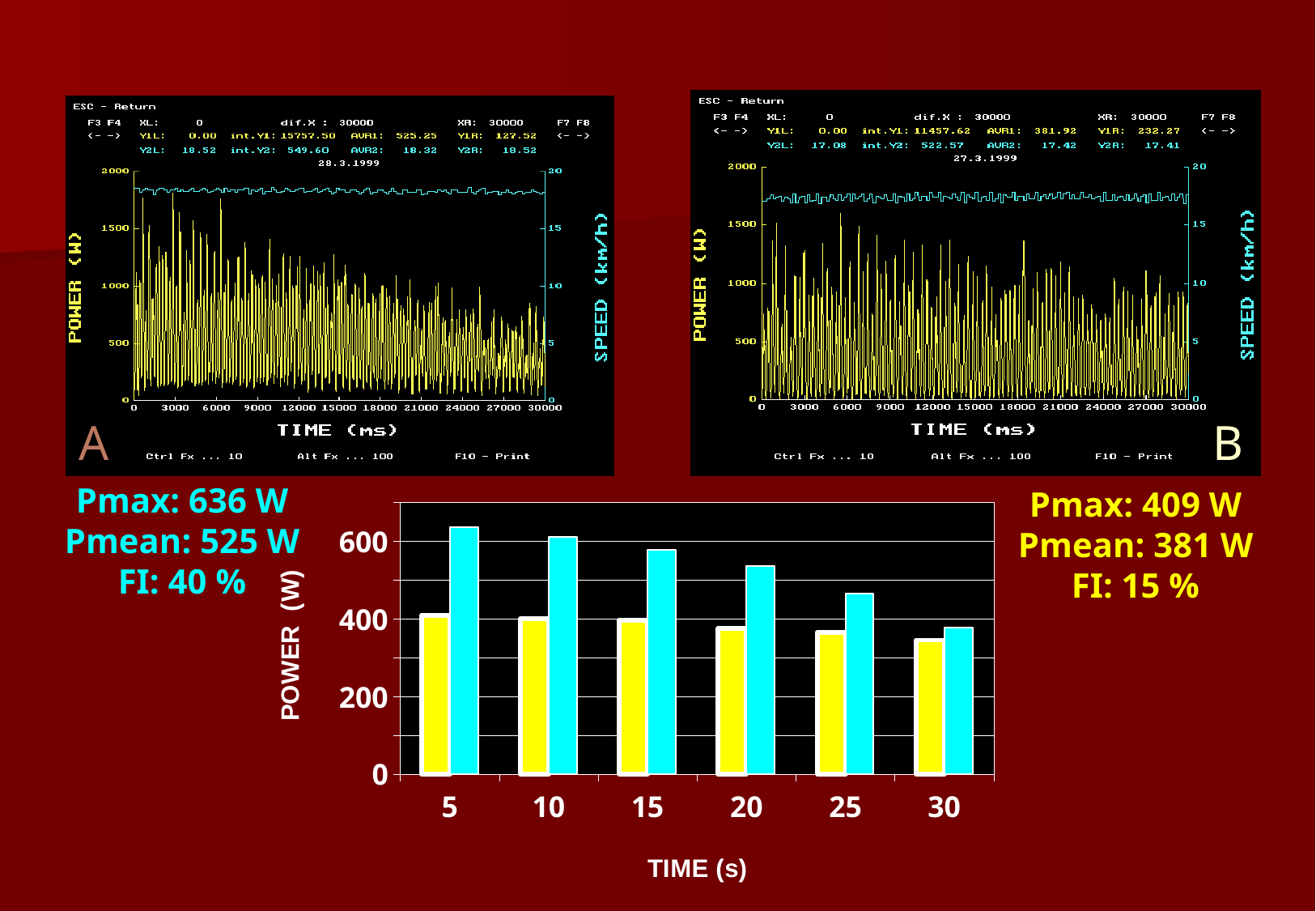
In the bottom bar chart, at which time is the cyan bar lowest? 30 In the bottom bar chart, how many time categories are shown on the x axis? 6 In the bottom bar chart, is the cyan bar at 5 s greater or less than 600? greater In the bottom bar chart, which bar is taller at 5 s, the yellow bar or the cyan bar? the cyan bar What kind of chart is the chart at the bottom of the slide with TIME (s) on the x axis? bar chart In the bottom bar chart, is the yellow bar at 30 s greater or less than 400? less What is the y-axis title of the bottom bar chart? POWER (W) In the bottom bar chart, do the cyan bars rise or fall as time increases from 5 to 30 s? fall In the bottom bar chart, at which time is the cyan bar highest? 5 In the bottom bar chart, how many bars are shown for each time category? 2 In chart A at the top left, what is the label of the right-hand y axis? SPEED (km/h) In the bottom bar chart, is the cyan bar at 30 s greater or less than 400? less